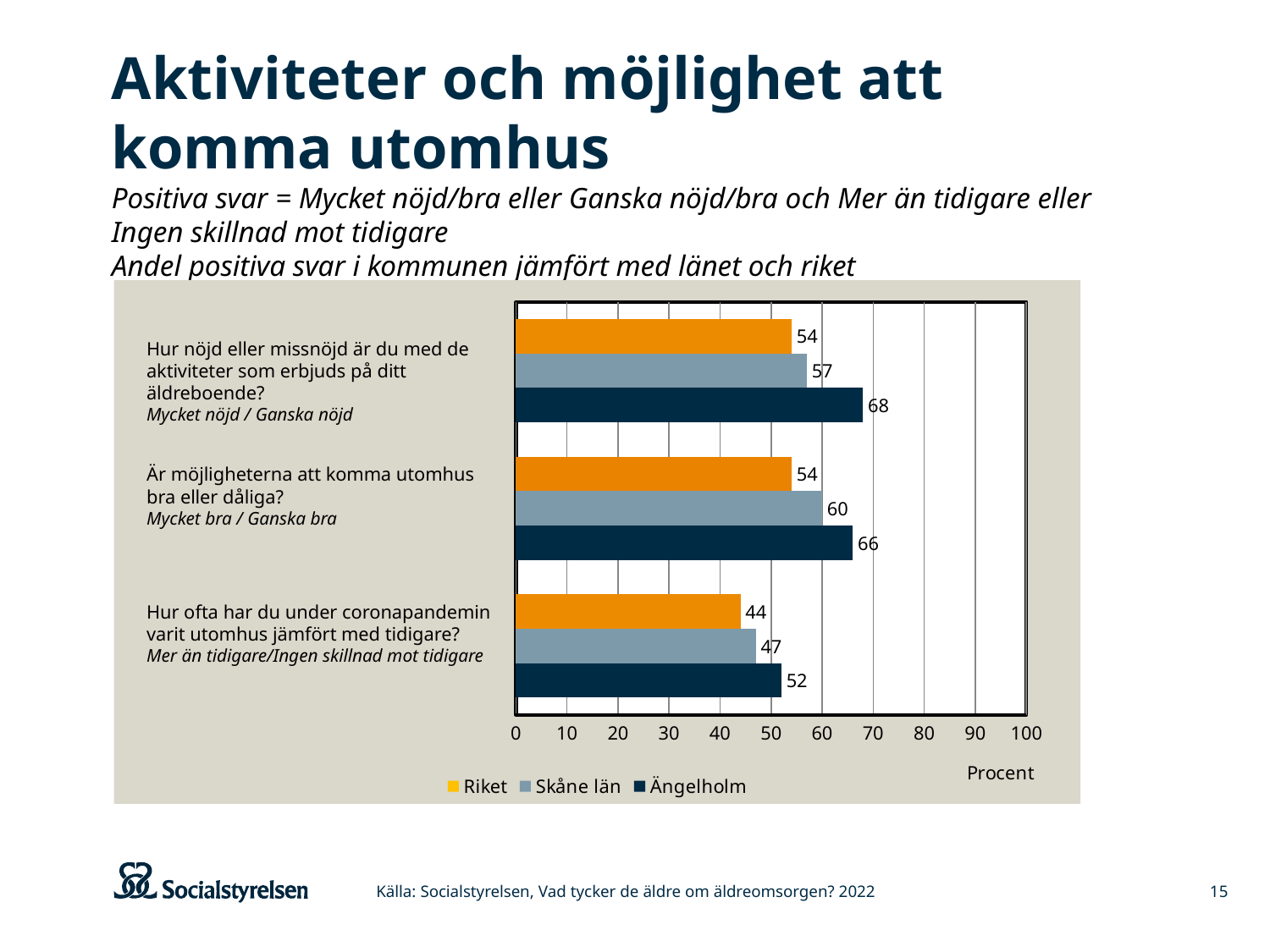
What kind of chart is shown on the slide? Bar chart What is the difference between Skåne län and Riket on the question about being outdoors during the corona pandemic? 3 Which is larger: the Ängelholm value for the activities question or the Ängelholm value for the opportunities to get outdoors question? The activities question (68) How many series does the legend list? 3 Which series has the highest value on the question about opportunities to get outdoors (Är möjligheterna att komma utomhus bra eller dåliga?)? Ängelholm How many questions (categories) are shown in the chart? 3 What unit label is shown on the horizontal axis of the chart? Procent What is the difference between Ängelholm and Riket on the question about satisfaction with activities offered at the care home? 14 What is the value for Riket on the question about how often respondents were outdoors during the corona pandemic compared to before? 44 What is the value for Skåne län on the question about opportunities to get outdoors (Är möjligheterna att komma utomhus bra eller dåliga?)? 60 Which series has the lowest value on the question about being outdoors during the corona pandemic? Riket What is the value for Ängelholm on the question about satisfaction with activities offered at the care home (Hur nöjd eller missnöjd är du med de aktiviteter som erbjuds på ditt äldreboende?)? 68